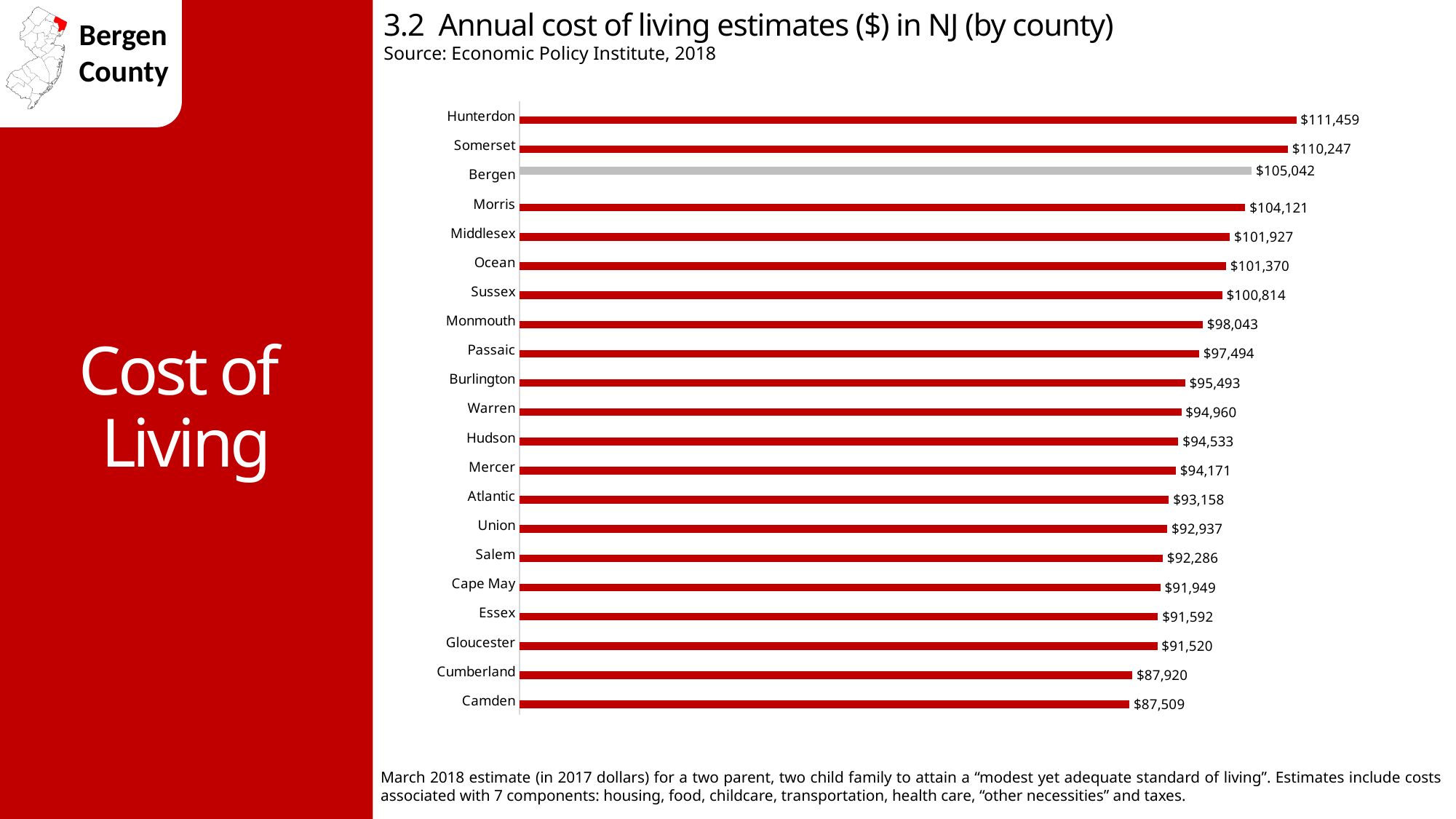
Which county's bar is shown in gray rather than red? Bergen What type of chart is used to show the cost of living estimates? Bar chart What is the difference between the cost of living estimates for Somerset and Bergen? $5,205 What is the difference between the cost of living estimates for Hunterdon and Camden? $23,950 Which county has the highest annual cost of living estimate? Hunterdon What is the annual cost of living estimate for Monmouth County? $98,043 Which county has a higher cost of living estimate, Cumberland or Gloucester? Gloucester Which county has a higher cost of living estimate, Passaic or Burlington? Passaic What is the annual cost of living estimate for Bergen County? $105,042 How many counties are shown in the chart? 21 Which county has the lowest annual cost of living estimate? Camden What is the annual cost of living estimate for Camden County? $87,509